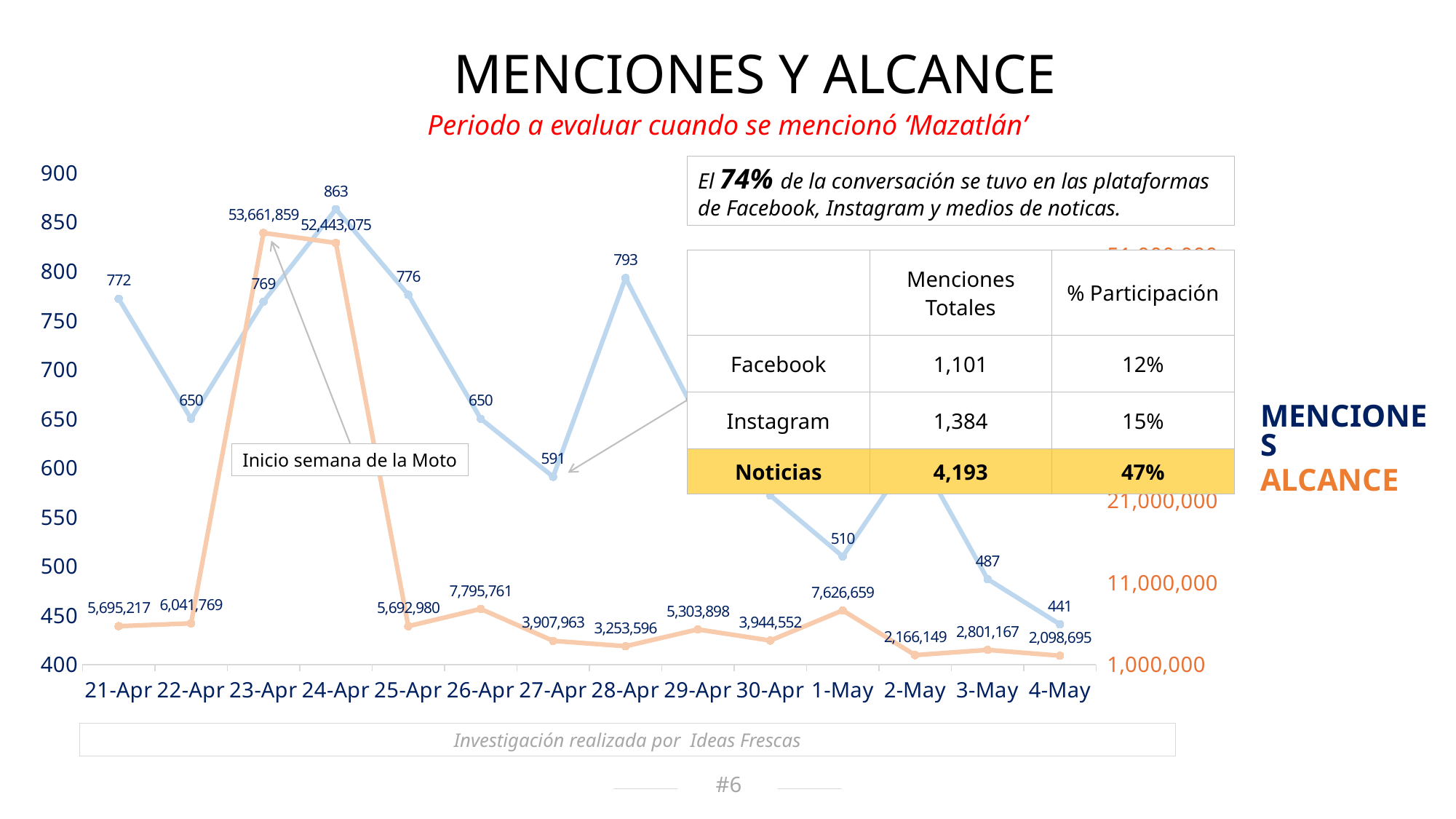
What is the Alcance value on 23-Apr? 53,661,859 What is the difference between the Menciones values on 24-Apr and 21-Apr? 91 What is the Menciones value on 4-May? 441 On which date is Menciones highest? 24-Apr What type of chart is shown on the slide? line chart How many dates are shown on the x axis of the chart? 14 What are the names of the two series plotted on the chart? Menciones and Alcance What is the Menciones value on 24-Apr? 863 Do the Menciones values rise or fall from 24-Apr to 27-Apr? fall On which date is Alcance lowest? 4-May How many series does the chart plot? 2 Which date has the higher Menciones value, 23-Apr or 26-Apr? 23-Apr